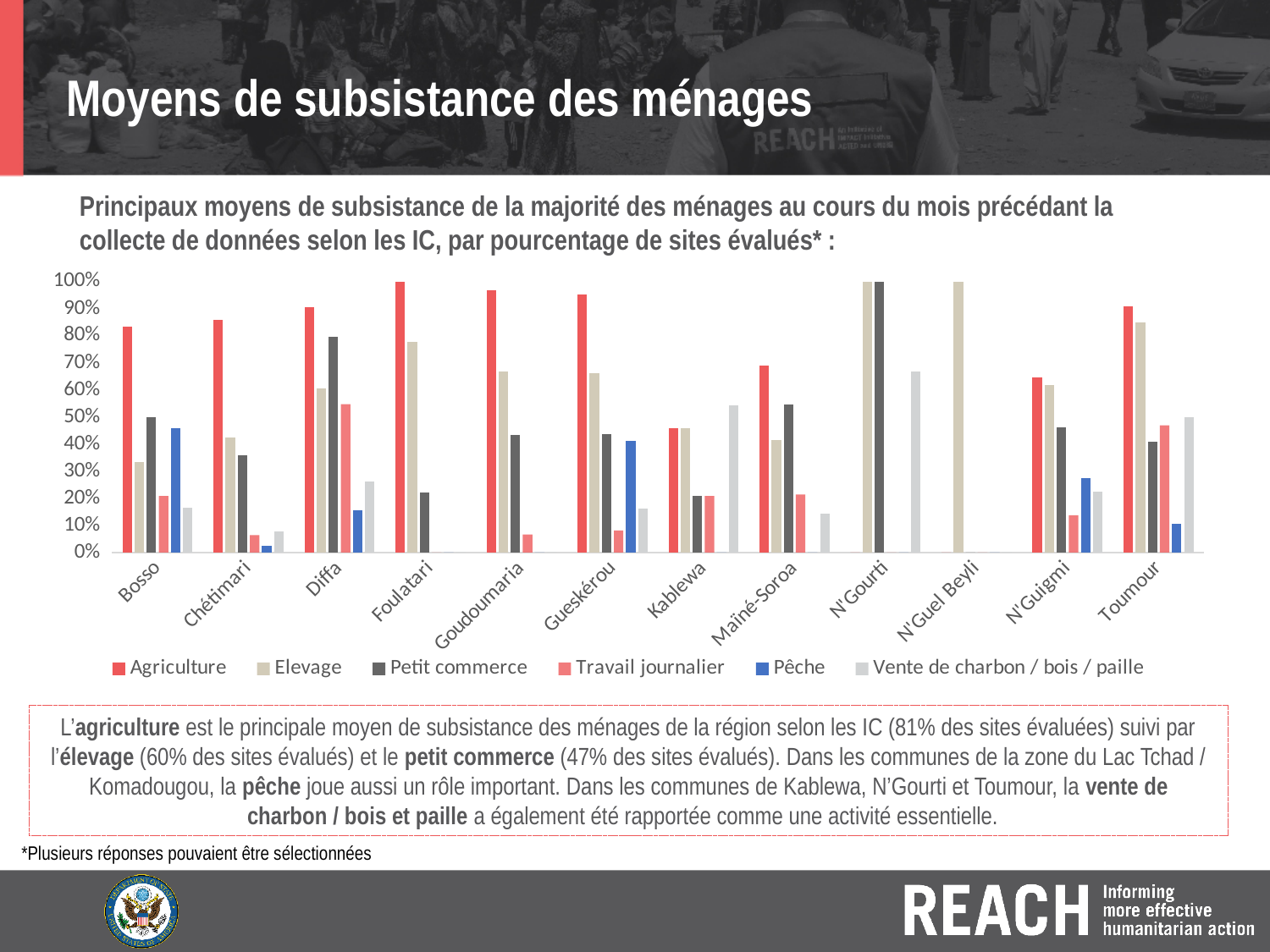
How many communes (categories) are shown on the x axis of the chart? 12 In Diffa, which is larger: Elevage or Petit commerce? Petit commerce What kind of chart is shown on the slide? Bar chart Which series has the lowest value in Chétimari? Pêche Is the value for Petit commerce in Diffa greater or less than 70%? greater What is the value for Agriculture in Foulatari? 100% In Bosso, which is larger: Agriculture or Elevage? Agriculture Is the value for Agriculture in Maïné-Soroa greater or less than 60%? greater Which colour represents Pêche in the legend? Blue Is the value for Pêche in Chétimari greater or less than 10%? less How many series does the chart legend list? 6 What is the value for Elevage in N'Guel Beyli? 100%